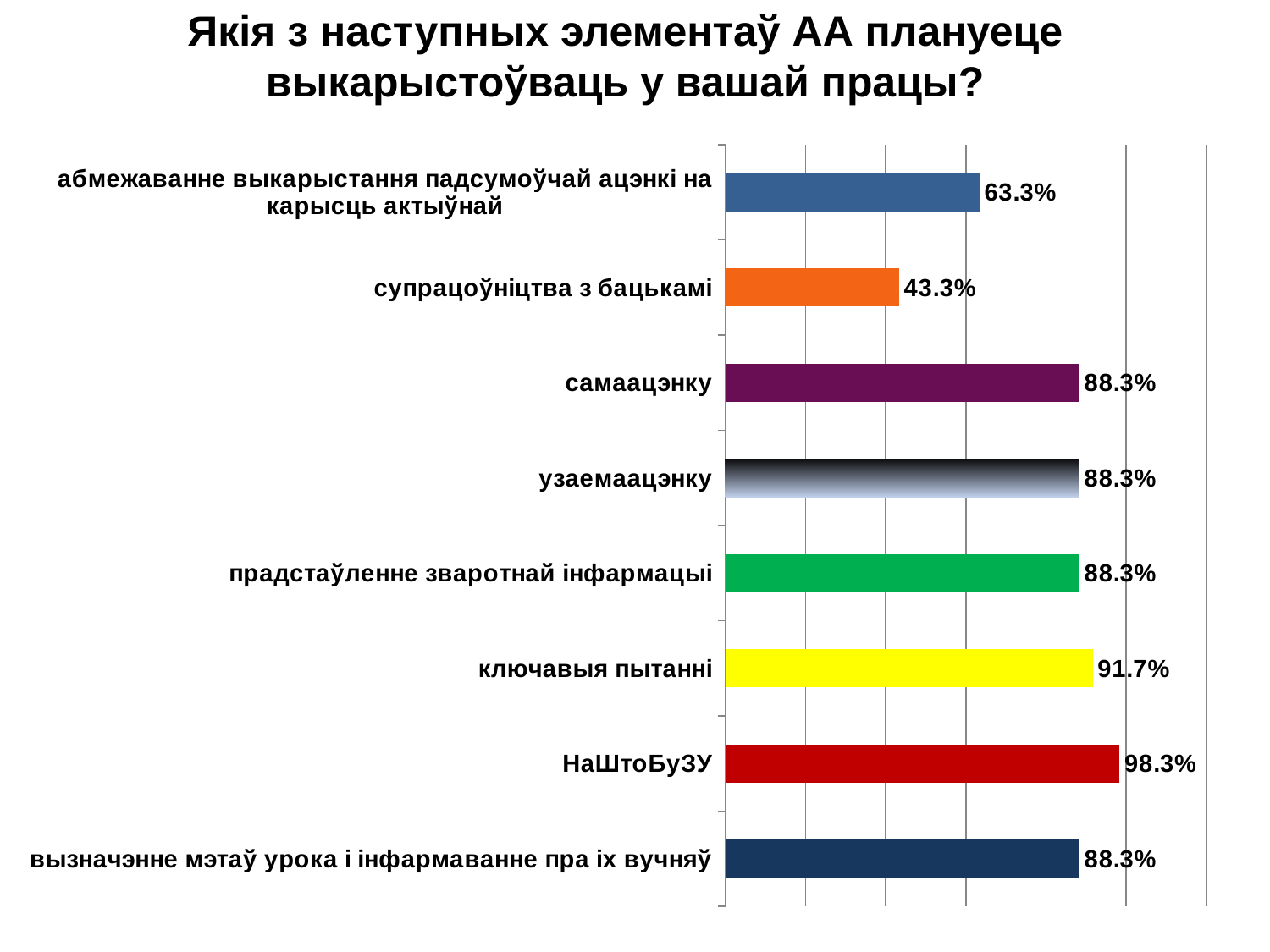
What kind of chart is shown on the slide? bar chart What is the value for супрацоўніцтва з бацькамі? 43.3% Which is larger, the value for ключавыя пытанні or the value for узаемаацэнку? ключавыя пытанні What is the value for НаШтоБуЗУ? 98.3% What is the difference between the values for ключавыя пытанні and самаацэнку? 3.4% What is the value for ключавыя пытанні? 91.7% How many categories are shown in the chart? 8 Which category has the highest value? НаШтоБуЗУ What is the difference between the values for НаШтоБуЗУ and супрацоўніцтва з бацькамі? 55.0% Which category is shown with a red bar? НаШтоБуЗУ Which category has the lowest value? супрацоўніцтва з бацькамі What is the value for абмежаванне выкарыстання падсумоўчай ацэнкі на карысць актыўнай? 63.3%